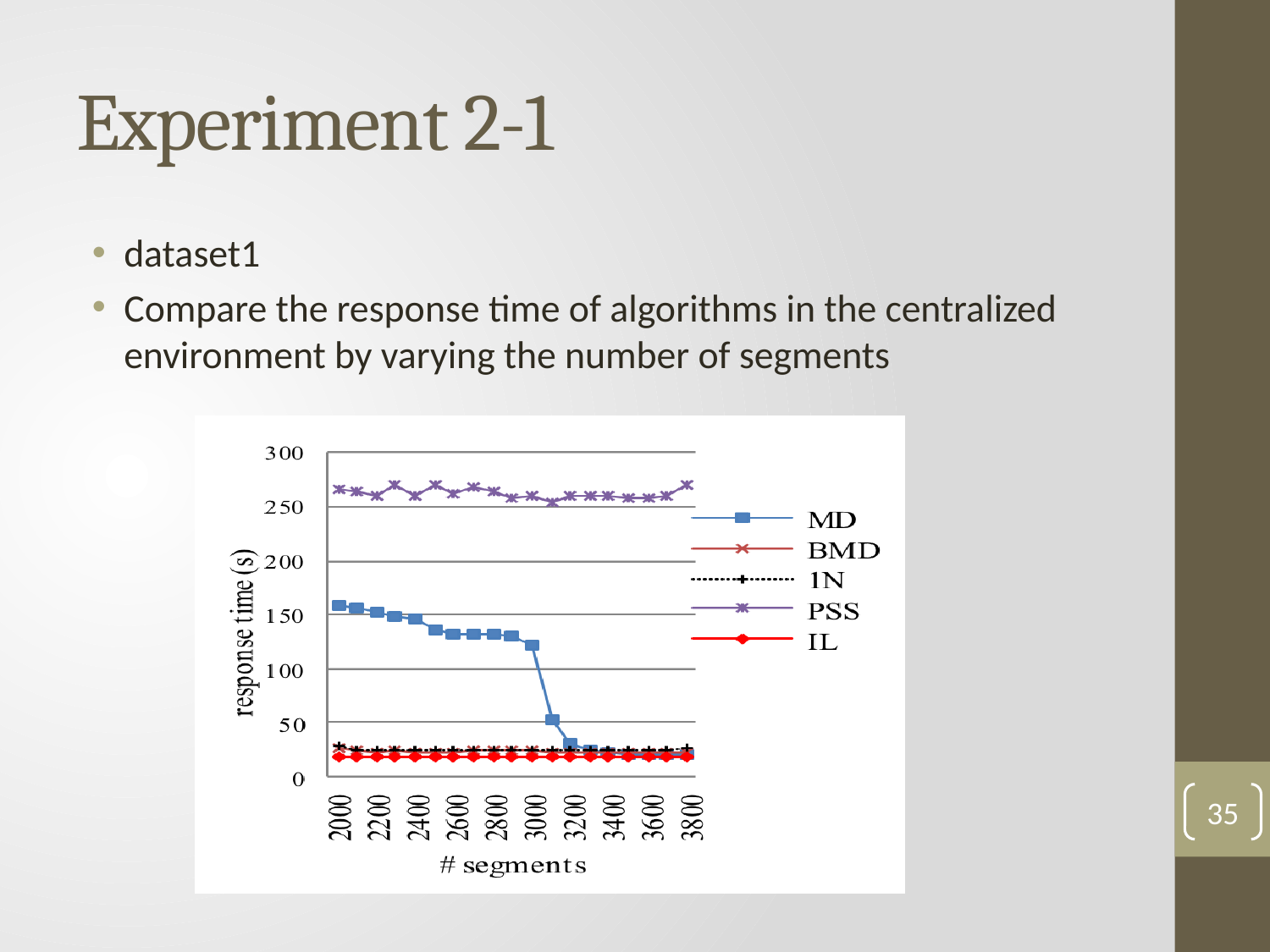
How many series does the legend list? 5 What is the label of the x axis? # segments Is the response time for IL at 3000 segments greater or less than 50? less Is the response time for MD at 3800 segments greater or less than 50? less Is the response time for PSS at 2000 segments greater or less than 250? greater Which series has the highest response time at 2000 segments? PSS At 2000 segments, which has the larger response time, MD or IL? MD What is the label of the y axis? response time (s) Does the response time for MD rise or fall as the number of segments increases? fall What kind of chart is shown on the slide? line chart How many tick labels are shown on the x axis? 10